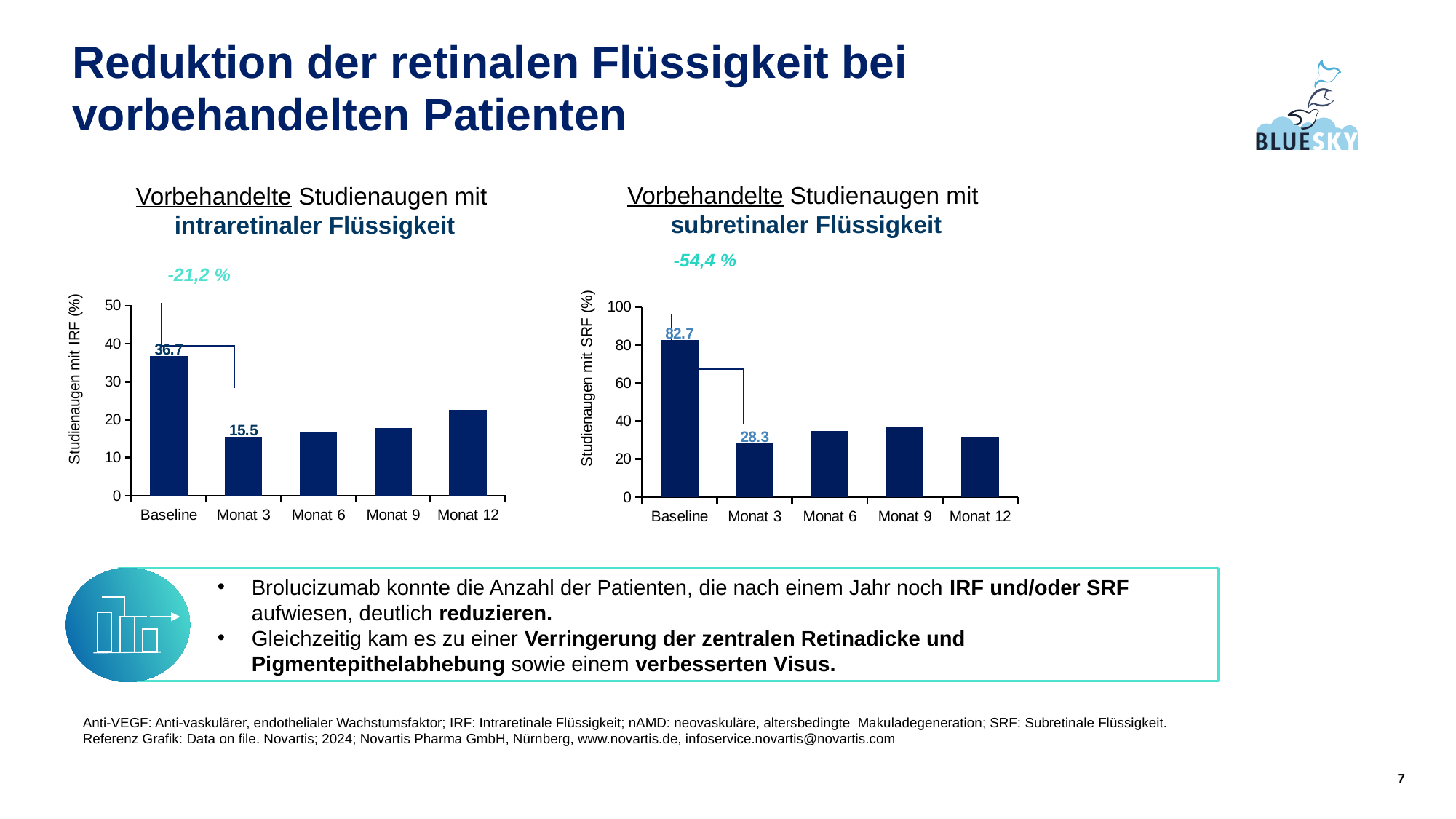
In the chart on the left (intraretinaler Flüssigkeit), which time point has the lowest value? Monat 3 In the chart on the right (subretinaler Flüssigkeit), what is the value for Baseline? 82.7 In the chart on the left (intraretinaler Flüssigkeit), what is the value for Baseline? 36.7 In the chart on the left (intraretinaler Flüssigkeit), what is the difference between the Baseline value and the Monat 3 value? 21.2 In the chart on the right (subretinaler Flüssigkeit), which time point has the highest value? Baseline What kind of chart is used for the subretinaler Flüssigkeit data on the right? Bar chart In the chart on the right (subretinaler Flüssigkeit), what is the value for Monat 3? 28.3 In the chart on the right (subretinaler Flüssigkeit), what is the difference between the Baseline value and the Monat 3 value? 54.4 In the chart on the right (subretinaler Flüssigkeit), is the value for Monat 6 greater or less than 40? less How many time points are shown on the x axis of the chart on the left (intraretinaler Flüssigkeit)? 5 In the chart on the left (intraretinaler Flüssigkeit), what is the value for Monat 3? 15.5 In the chart on the left (intraretinaler Flüssigkeit), is the value for Monat 12 greater or less than 20? greater